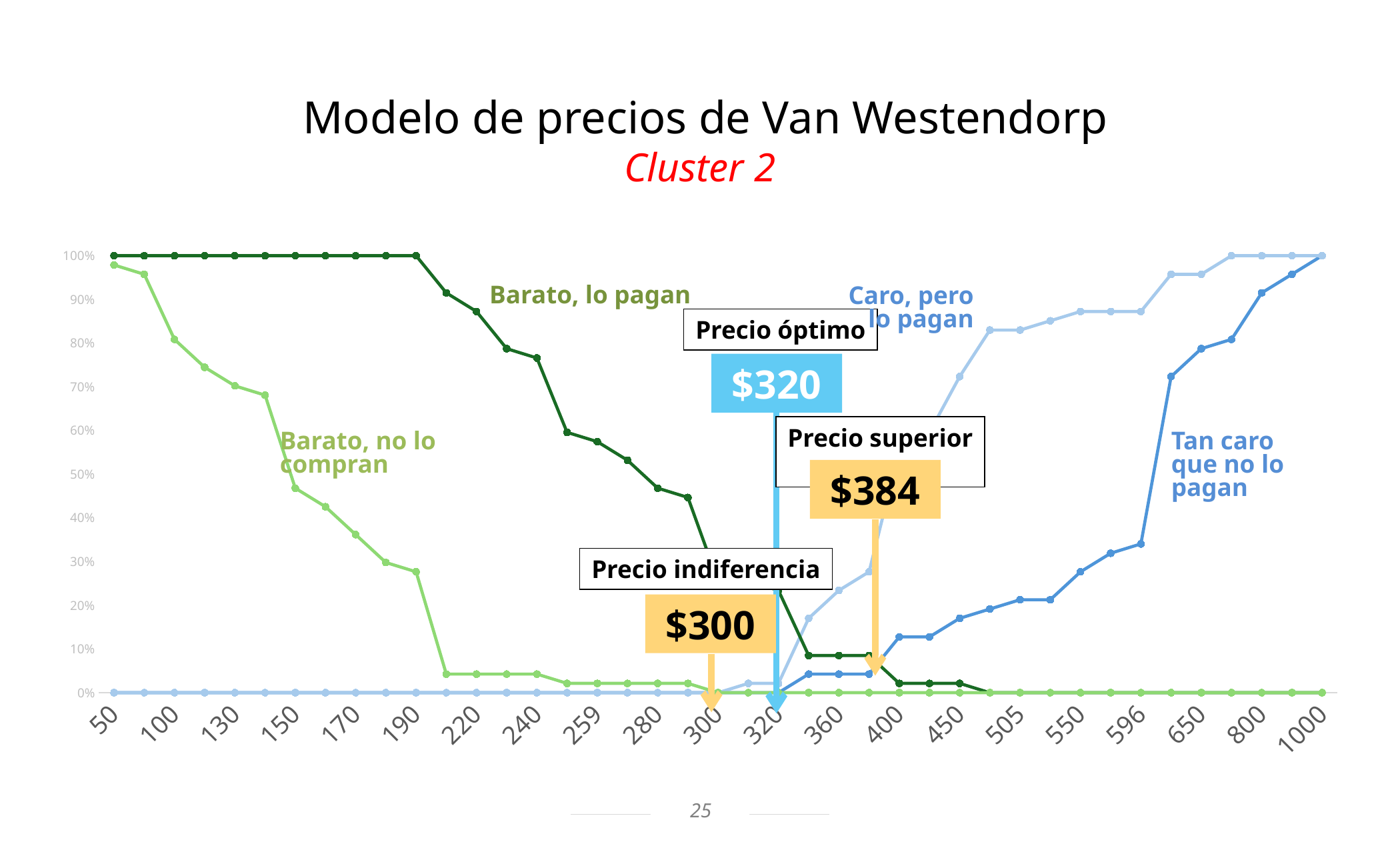
Which is higher, the 'Precio óptimo' or the 'Precio superior'? Precio superior What is the title of the chart on the slide? Modelo de precios de Van Westendorp What price is labelled as the 'Precio óptimo'? $320 What kind of chart is shown on the slide? line chart What is the value of the 'Tan caro que no lo pagan' line at a price of 1000? 100% Does the 'Barato, no lo compran' line rise or fall as the price increases along the x axis? fall What is the value of the 'Barato, lo pagan' line at a price of 50? 100% How many series (lines) are plotted on the chart? 4 What price is labelled as the 'Precio indiferencia'? $300 What price is labelled as the 'Precio superior'? $384 What is the difference between the 'Precio superior' and the 'Precio indiferencia'? $84 Is the value of the 'Caro, pero lo pagan' line at a price of 596 greater or less than 80%? greater